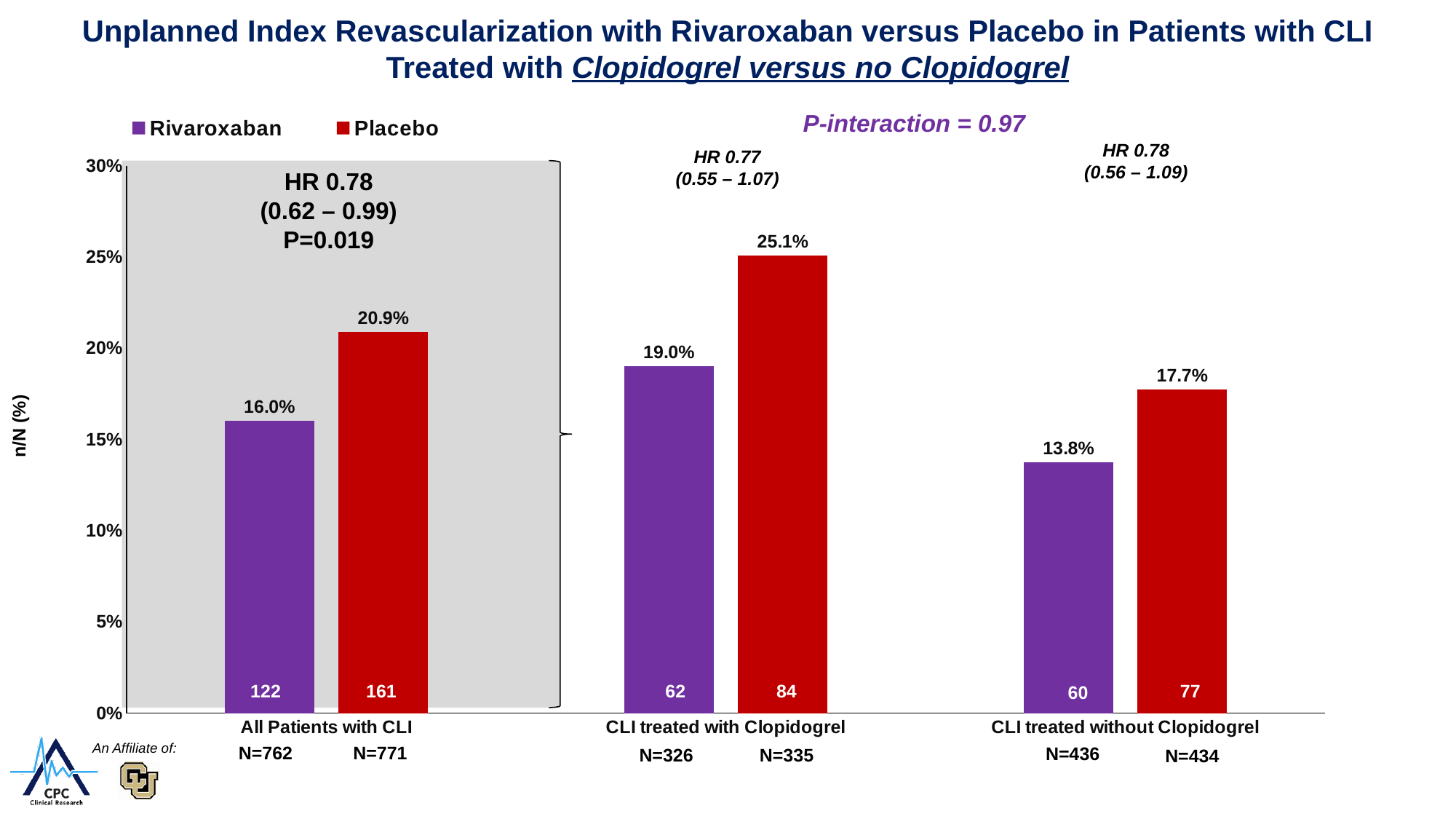
What kind of chart is shown on the slide? bar chart What is the difference between the Placebo and Rivaroxaban values for All Patients with CLI? 4.9% Which is larger for CLI treated without Clopidogrel, the Rivaroxaban value or the Placebo value? Placebo Is the Placebo value for CLI treated with Clopidogrel greater or less than 25%? greater How many series does the legend list? 2 What is the Rivaroxaban value for CLI treated without Clopidogrel? 13.8% Which category has the highest Placebo value? CLI treated with Clopidogrel What is the Placebo value for CLI treated with Clopidogrel? 25.1% What is the P-interaction value shown on the slide? 0.97 Which category has the lowest Rivaroxaban value? CLI treated without Clopidogrel How many categories are shown on the x axis? 3 What is the Rivaroxaban value for All Patients with CLI? 16.0%